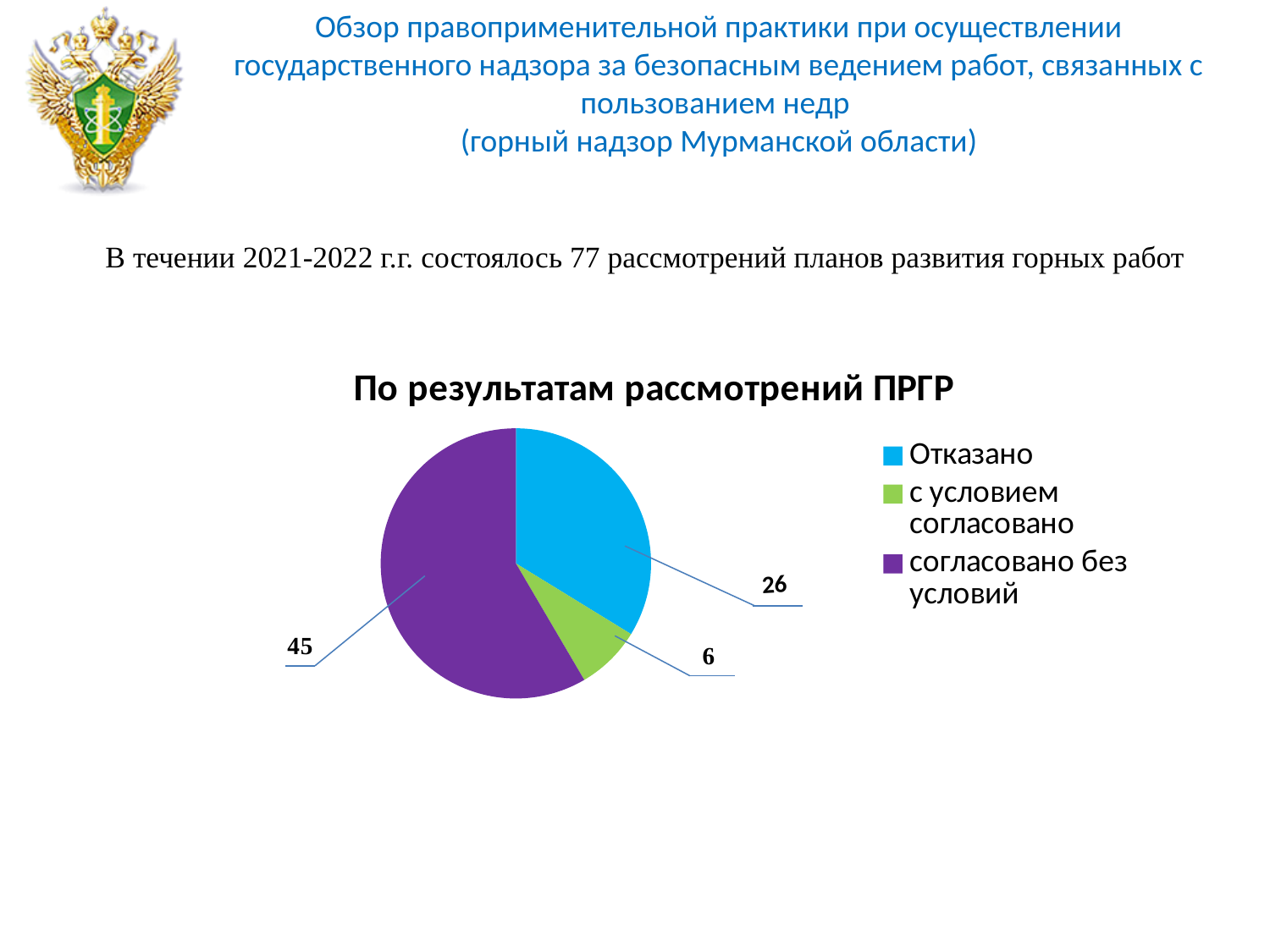
How many entries does the legend list? 3 Which category has the largest slice? согласовано без условий What kind of chart is shown on the slide? pie chart Which category has the smallest slice? с условием согласовано What is the difference between "согласовано без условий" and "Отказано"? 19 How many slices does the pie chart have? 3 What is the value for "согласовано без условий"? 45 What is the value for "Отказано"? 26 What is the total of all slices in the pie chart? 77 What is the title of the chart? По результатам рассмотрений ПРГР Which is larger, "Отказано" or "с условием согласовано"? Отказано What is the value for "с условием согласовано"? 6